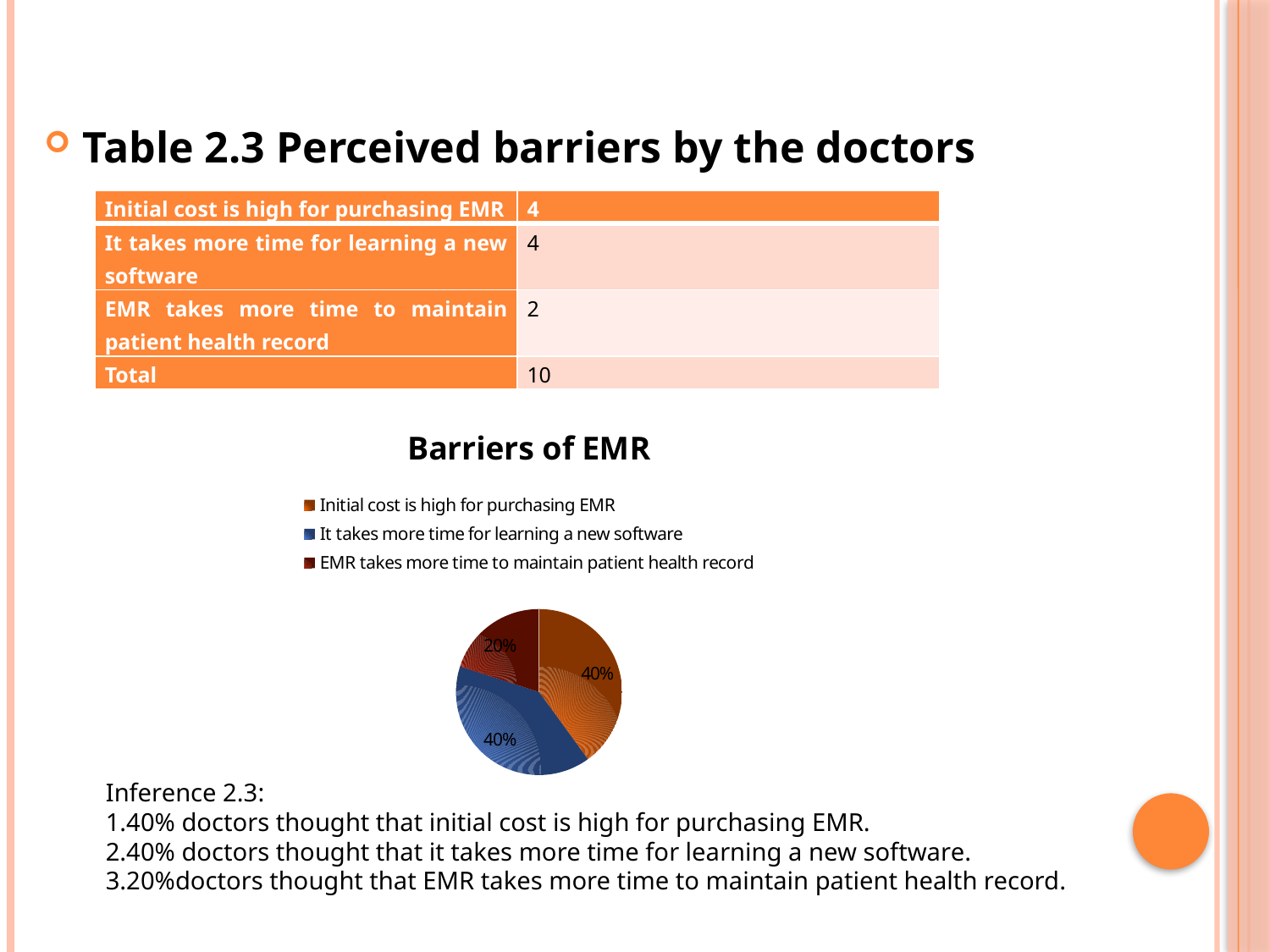
What kind of chart is shown under the title "Barriers of EMR"? pie chart Which category has the smallest slice in the pie chart? EMR takes more time to maintain patient health record How many entries does the legend of the pie chart list? 3 What share of the pie chart is labelled for "Initial cost is high for purchasing EMR"? 40% What share of the pie chart is labelled for "It takes more time for learning a new software"? 40% Which slice is larger in the pie chart: "Initial cost is high for purchasing EMR" or "EMR takes more time to maintain patient health record"? Initial cost is high for purchasing EMR Which legend entry is shown in blue in the pie chart? It takes more time for learning a new software How many slices does the pie chart have? 3 What is the title of the chart on the slide? Barriers of EMR What is the difference in percentage points between the "It takes more time for learning a new software" slice and the "EMR takes more time to maintain patient health record" slice? 20% What share of the pie chart is labelled for "EMR takes more time to maintain patient health record"? 20%